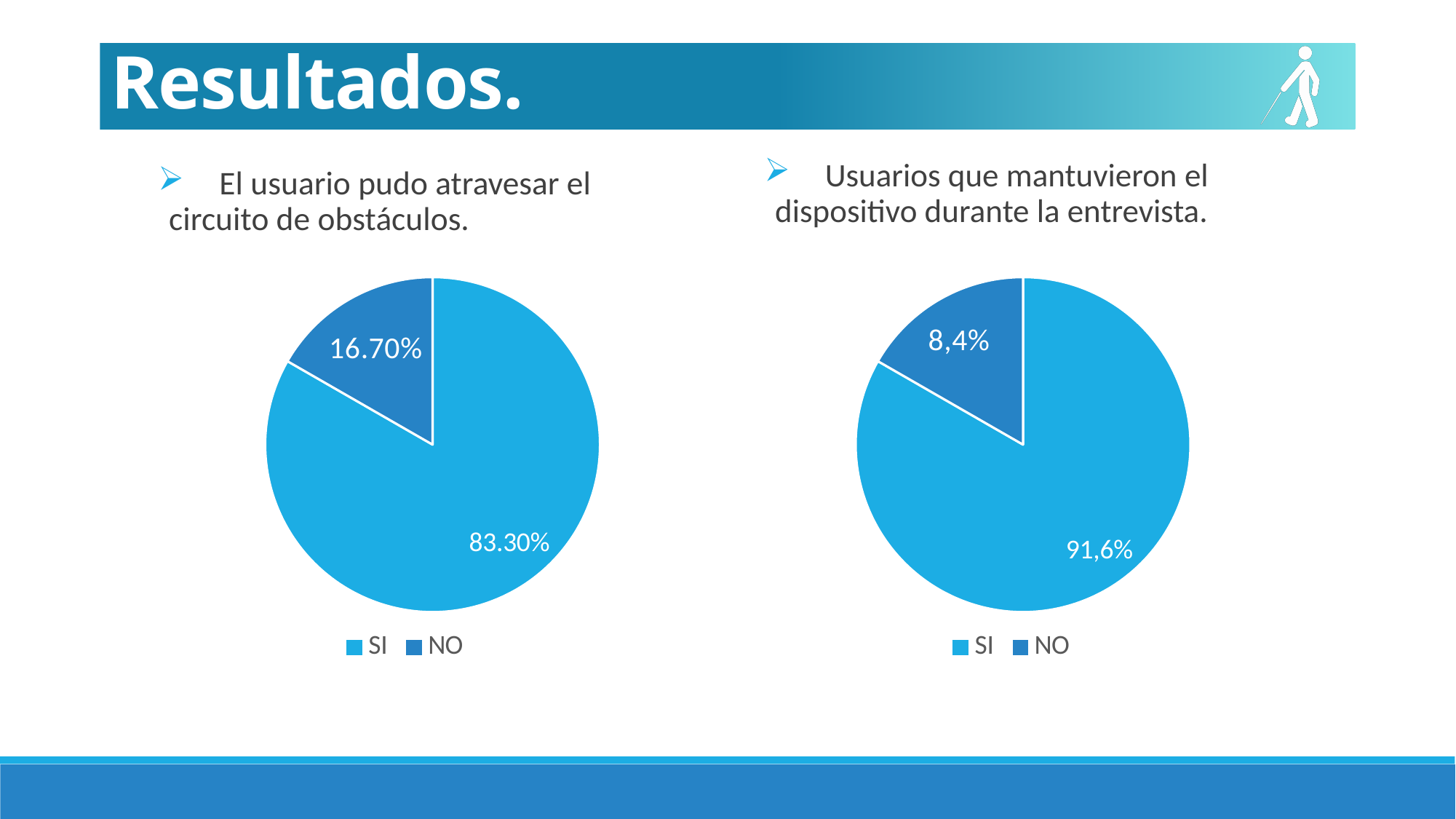
In the right pie chart (Usuarios que mantuvieron el dispositivo durante la entrevista), what is the value for SI? 91,6% In the left pie chart, which is larger, SI or NO? SI In the right pie chart (Usuarios que mantuvieron el dispositivo durante la entrevista), what is the value for NO? 8,4% How many slices does the left pie chart have? 2 What type of chart is used on the left side of the slide? Pie chart In the right pie chart, what colour is the SI slice? Light blue How many categories does the legend of the right pie chart list? 2 In the right pie chart, which category has the smallest slice? NO In the left pie chart (El usuario pudo atravesar el circuito de obstáculos), what is the value for NO? 16.70% In the left pie chart, which category has the largest slice? SI In the left pie chart (El usuario pudo atravesar el circuito de obstáculos), what is the value for SI? 83.30%